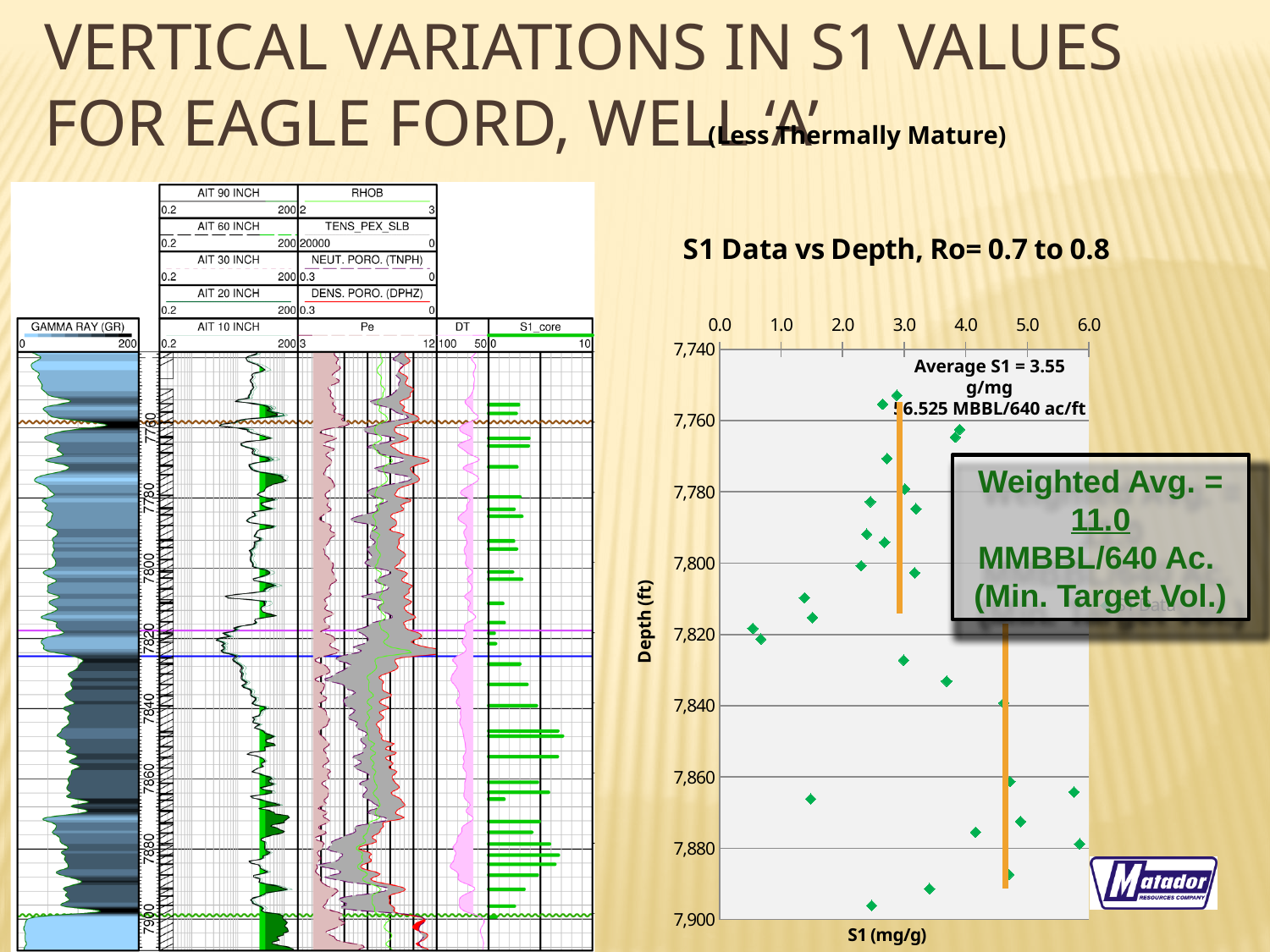
In the 'S1 Data vs Depth' chart, what weighted average (minimum target volume) is stated in the boxed annotation? 11.0 MMBBL/640 Ac. What is the title of the chart on the right of the slide? S1 Data vs Depth, Ro= 0.7 to 0.8 In the 'S1 Data vs Depth' chart, what is the deepest depth tick shown on the y axis? 7,900 What kind of chart is the 'S1 Data vs Depth, Ro= 0.7 to 0.8' chart on the right of the slide? scatter chart In the 'S1 Data vs Depth' chart, are any points plotted with an S1 value greater than 5.0? yes In the 'S1 Data vs Depth' chart, what is the largest value shown on the x axis? 6.0 In the 'S1 Data vs Depth' chart, what is the label of the x axis? S1 (mg/g) In the well log on the left of the slide, what is the scale range of the GAMMA RAY (GR) track? 0 to 200 In the well log on the left of the slide, what is the scale range of the S1_core track? 0 to 10 In the 'S1 Data vs Depth' chart, as depth increases from 7,740 to 7,900 ft, do the S1 values generally increase or decrease? increase In the 'S1 Data vs Depth' chart, what average S1 value is stated in the annotation? 3.55 g/mg